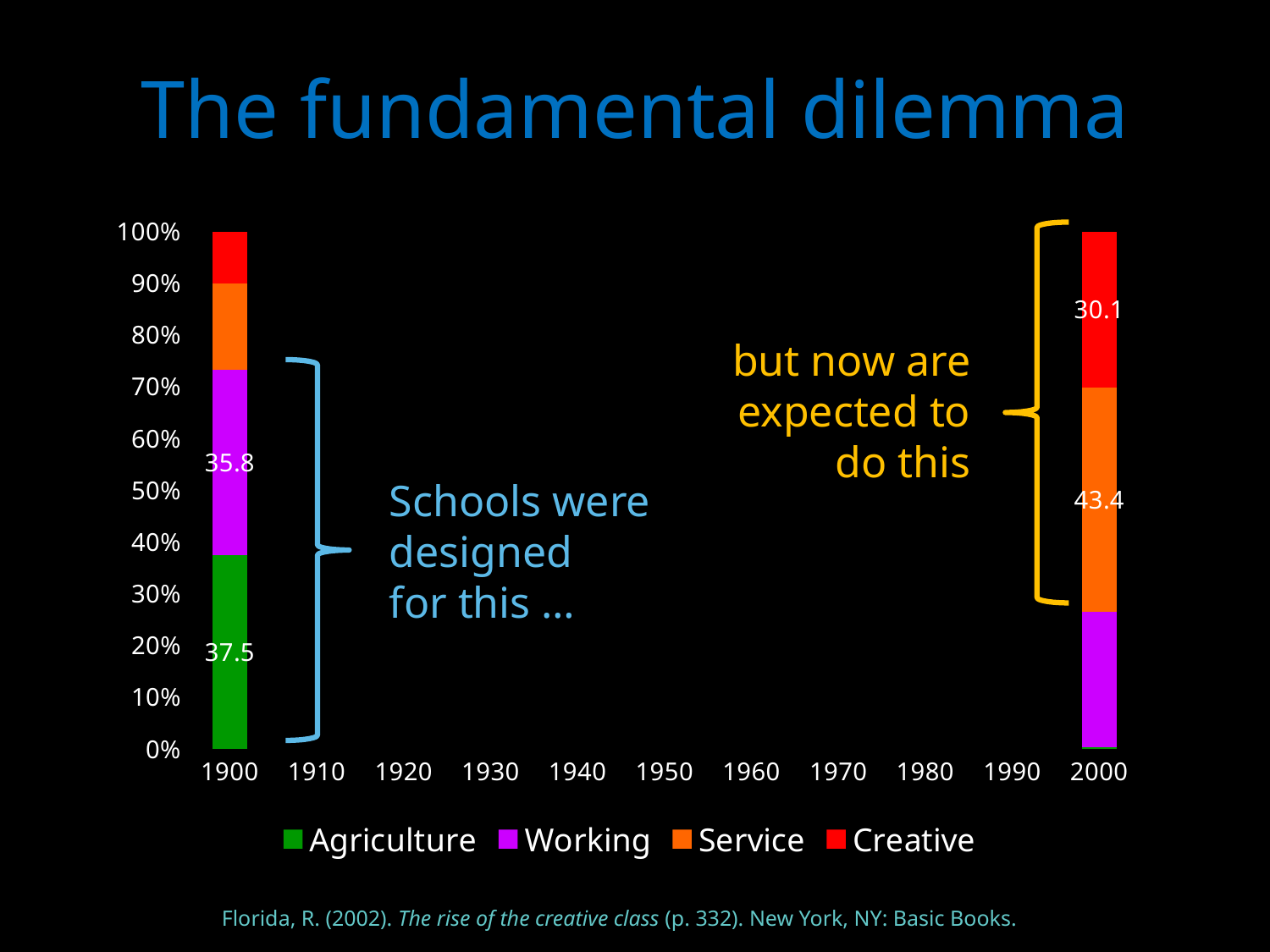
What is the difference between the Service and Creative values in 2000? 13.3 How many series does the legend list? 4 What colour represents Service in the legend? Orange Does the Creative share rise or fall from 1900 to 2000? Rise What kind of chart is shown on the slide? Stacked bar chart Is the Creative segment for 1900 greater or less than 20%? less What is the value of the Agriculture segment for 1900? 37.5 How many years have a bar plotted on the chart? 2 What is the value of the Working segment for 1900? 35.8 In 2000, which is larger, the Service segment or the Creative segment? Service What is the value of the Service segment for 2000? 43.4 What is the value of the Creative segment for 2000? 30.1